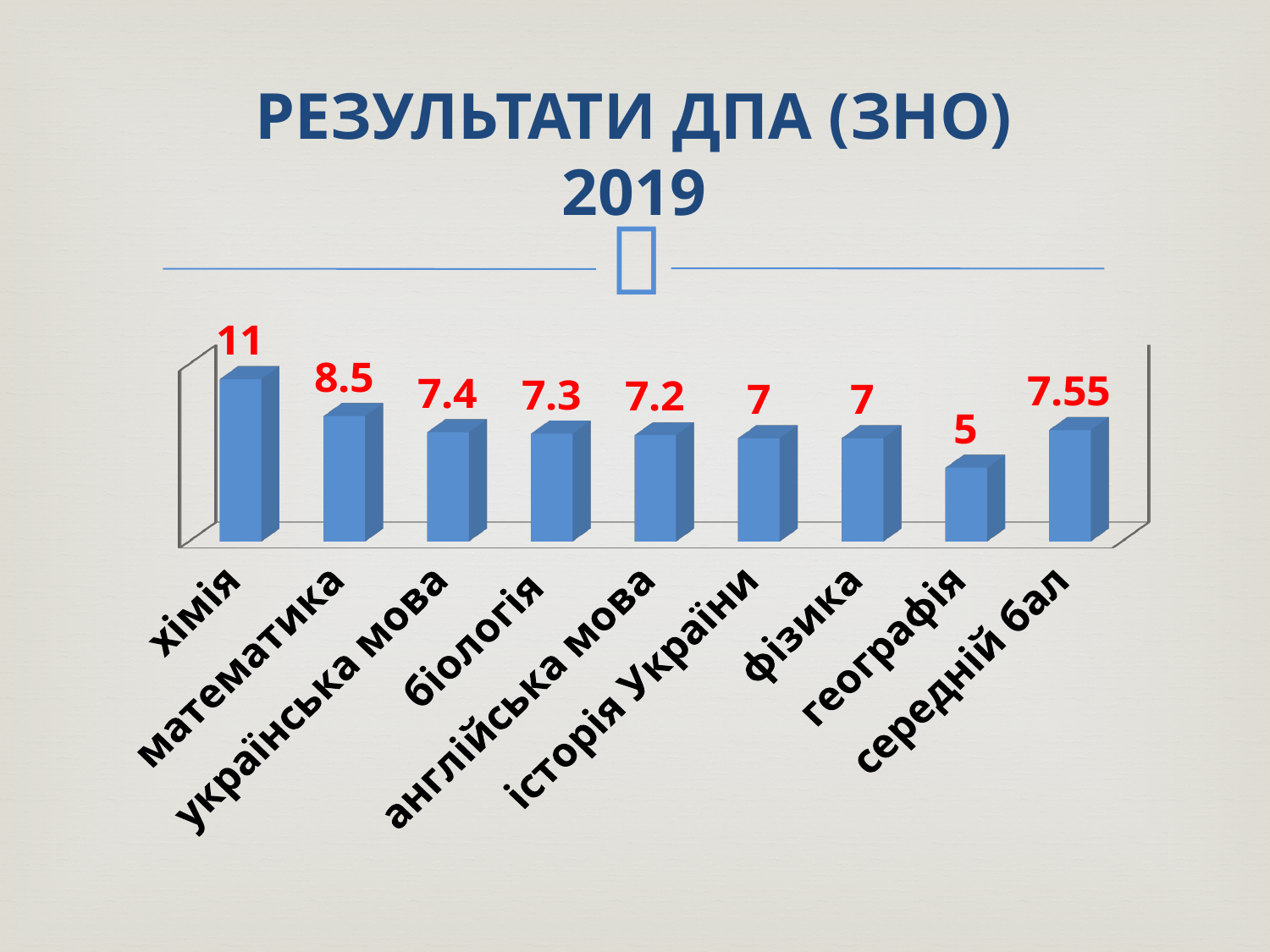
How many categories are shown on the x axis? 9 Which category has the lowest value? географія What is the title of the slide? РЕЗУЛЬТАТИ ДПА (ЗНО) 2019 What is the difference between the values for хімія and математика? 2.5 What is the value for хімія? 11 What is the value for географія? 5 What kind of chart is shown on the slide? bar chart What is the value for математика? 8.5 Which category has the highest value? хімія What is the difference between the values for українська мова and географія? 2.4 What is the value for середній бал? 7.55 Which is larger, the value for біологія or the value for фізика? біологія